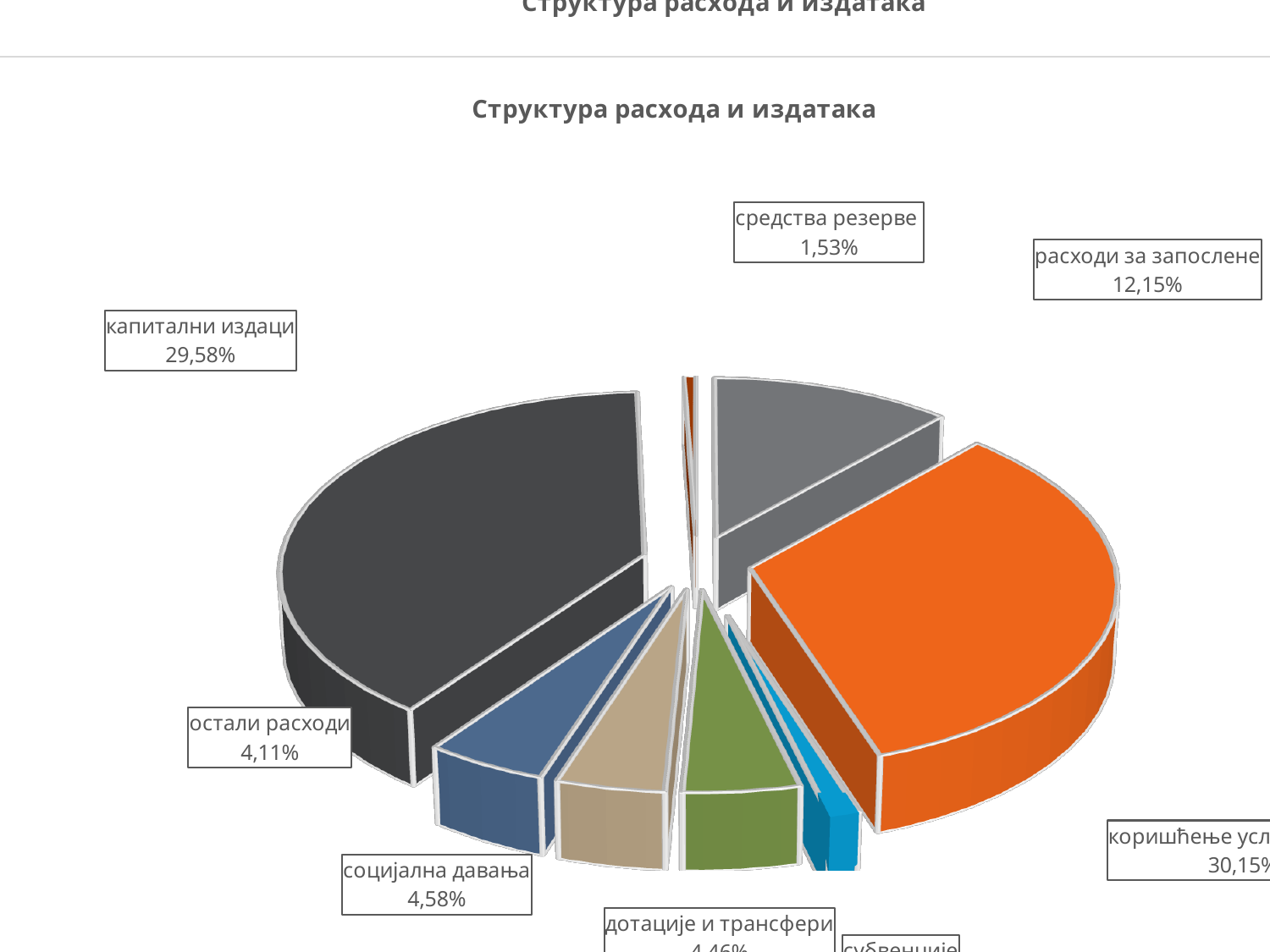
What percentage is labelled for средства резерве? 1,53% What share is shown for социјална давања? 4,58% What is the difference between капитални издаци and расходи за запослене? 17,43% What type of chart is shown on the slide? pie chart What share of the pie does капитални издаци represent? 29,58% Which is larger, социјална давања or остали расходи? социјална давања Which is larger, капитални издаци or расходи за запослене? капитални издаци By how much does социјална давања exceed остали расходи? 0,47% What is the value shown for расходи за запослене? 12,15% What is the difference between расходи за запослене and средства резерве? 10,62% What is the value for остали расходи? 4,11% What is the title of the chart? Структура расхода и издатака